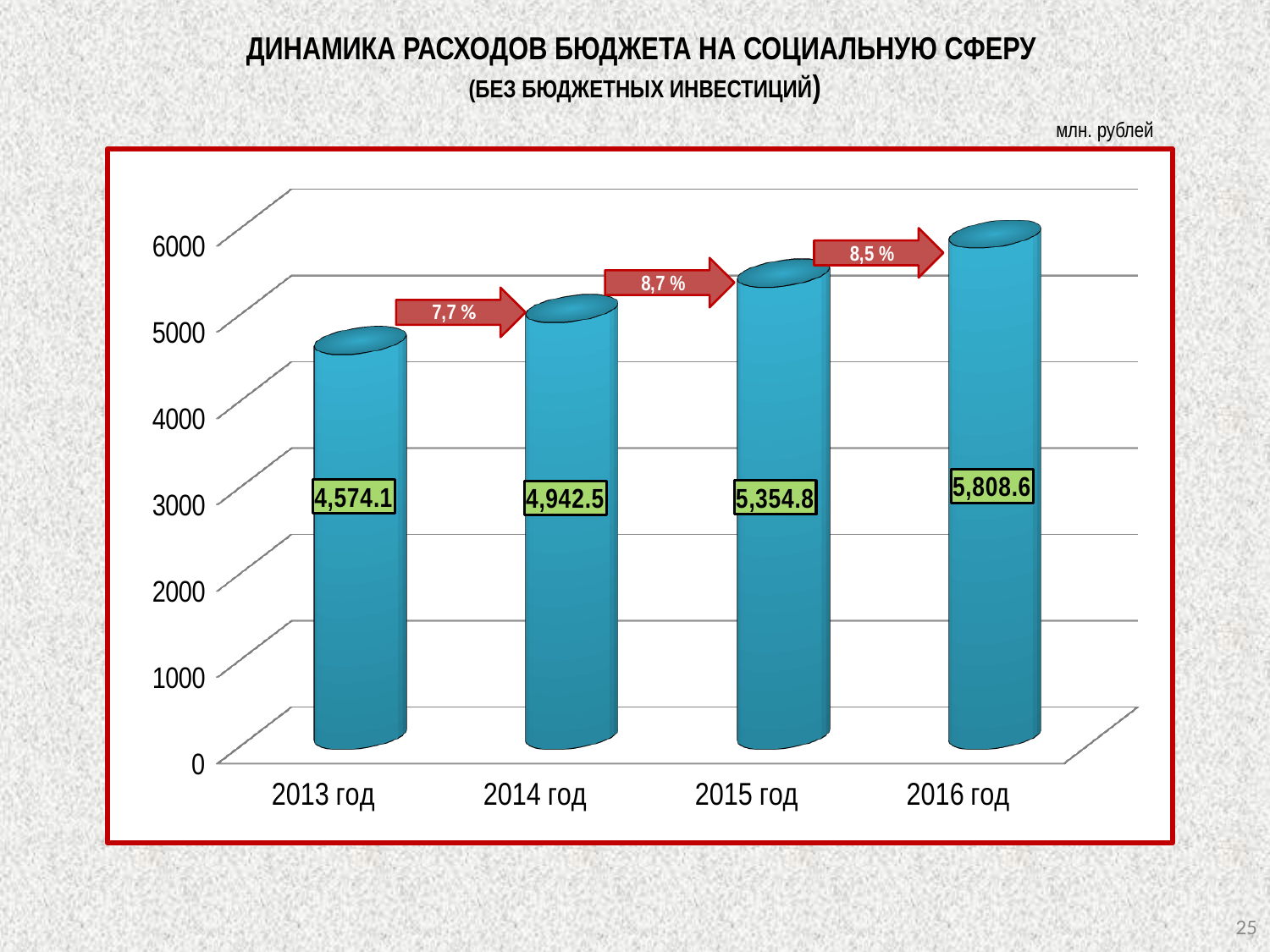
Is the value for 2014 год greater or less than 5000? less Which is larger, the value for 2014 год or the value for 2015 год? 2015 год What is the value for 2016 год? 5,808.6 What is the value for 2013 год? 4,574.1 What kind of chart is shown on the slide? bar chart What is the difference between the values for 2015 год and 2014 год? 412.3 What is the difference between the values for 2016 год and 2013 год? 1,234.5 Which year has the lowest value? 2013 год Which year has the highest value? 2016 год How many years are shown on the chart? 4 What is the value for 2015 год? 5,354.8 What percentage growth is shown by the arrow between 2014 год and 2015 год? 8,7 %